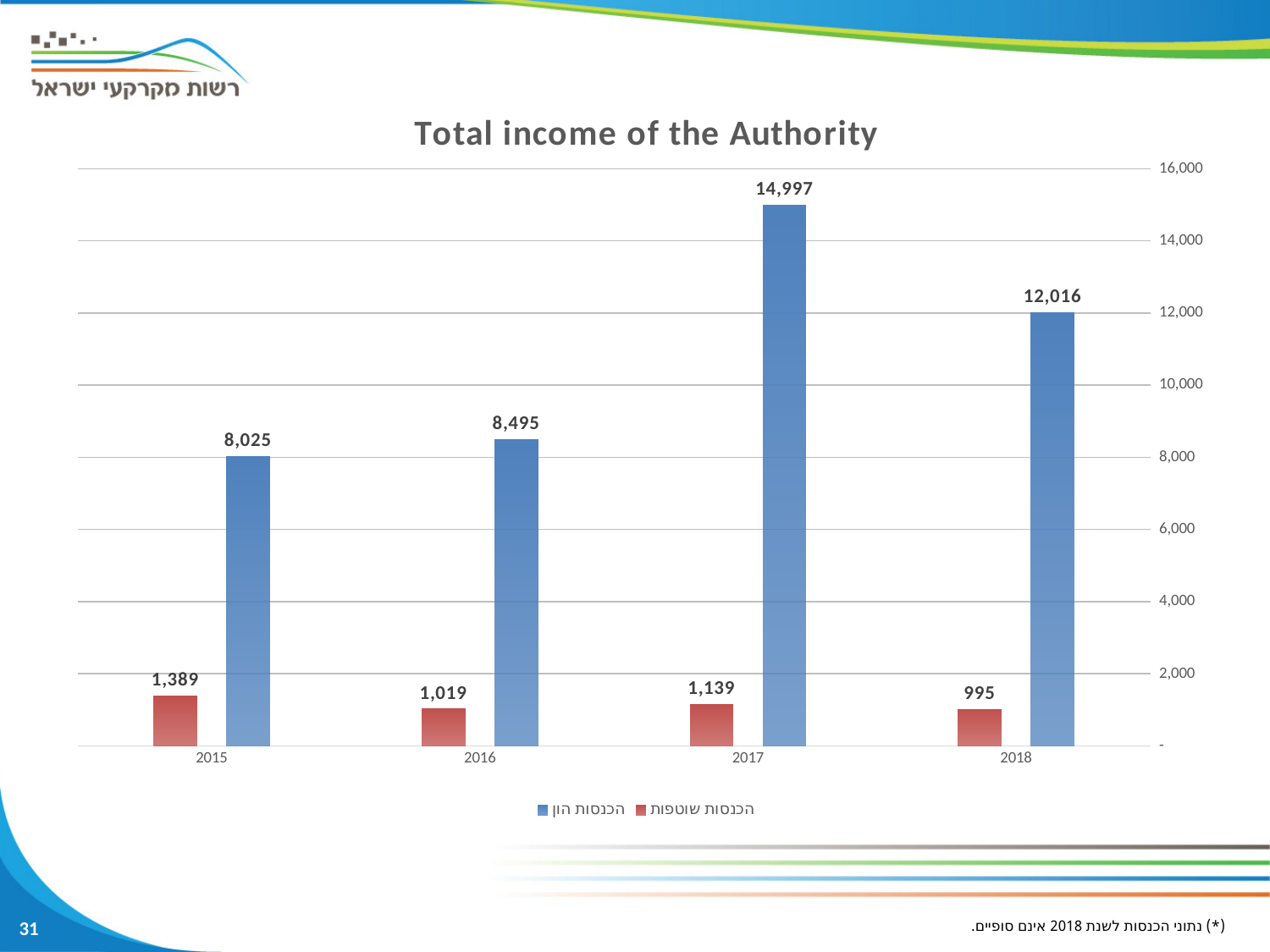
How many series does the legend list? 2 What is the title of the chart? Total income of the Authority What is the value of the red bar for 2015? 1,389 Which year has the highest blue bar? 2017 What type of chart is shown on the slide? bar chart What is the value of the blue bar for 2017? 14,997 What is the difference between the blue bar values for 2017 and 2018? 2,981 Which is larger, the blue bar for 2015 or the blue bar for 2016? 2016 What is the value of the blue bar for 2018? 12,016 Is the value of the blue bar for 2018 greater or less than 10,000? greater How many years are shown on the x axis? 4 Which year has the lowest red bar? 2018